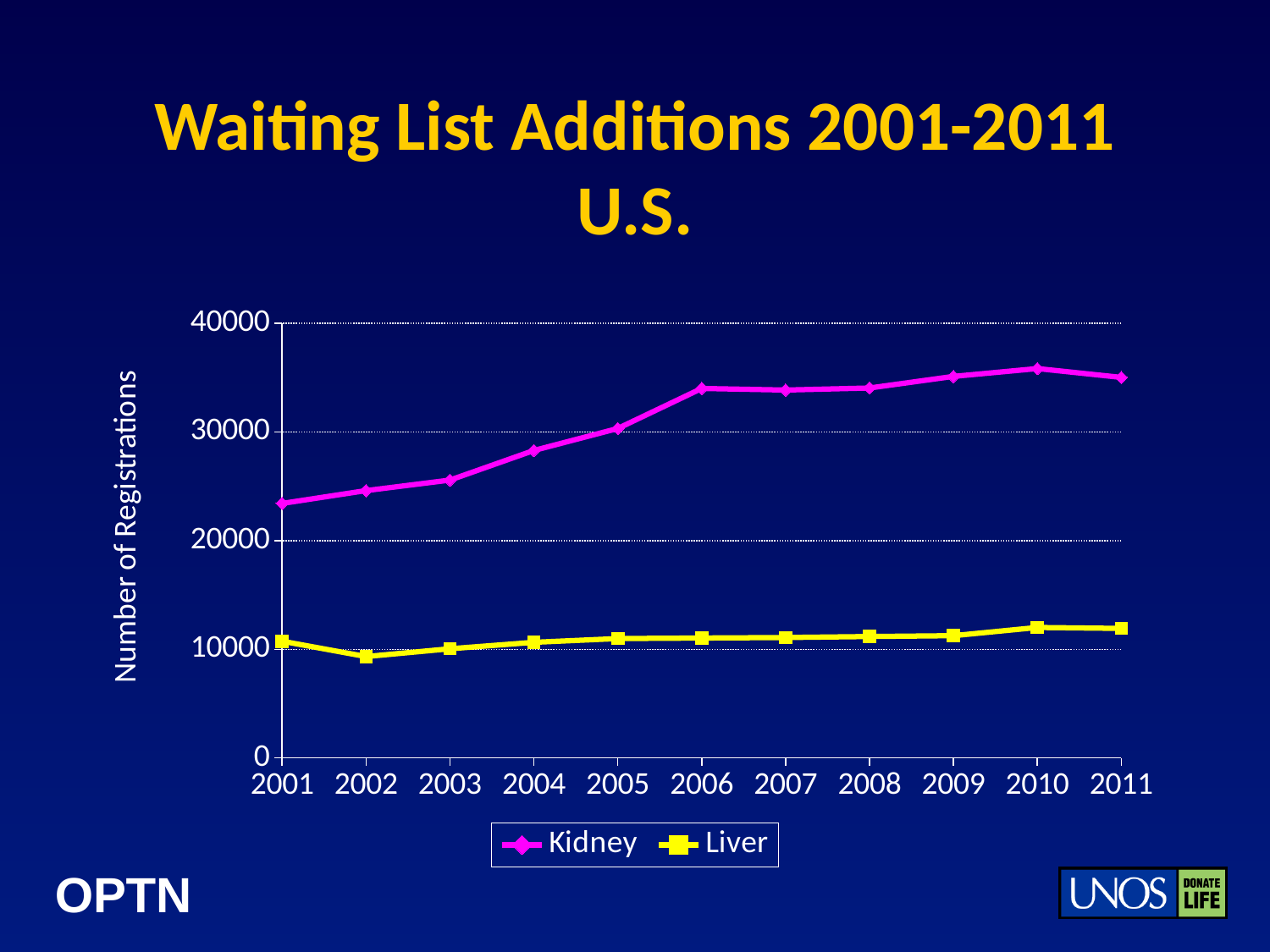
What is the title of the y axis? Number of Registrations Is the Kidney value for 2006 greater or less than 30000? greater What kind of chart is shown on the slide? Line chart How many years are plotted along the x axis? 11 In which year is the Kidney series at its lowest? 2001 Is the Kidney value for 2001 greater or less than 20000? greater In which year is the Liver series at its lowest? 2002 Is the Kidney value for 2011 greater or less than 40000? less In which year is the Kidney series at its highest? 2010 How many series does the legend list? 2 In 2005, which series has the larger value, Kidney or Liver? Kidney